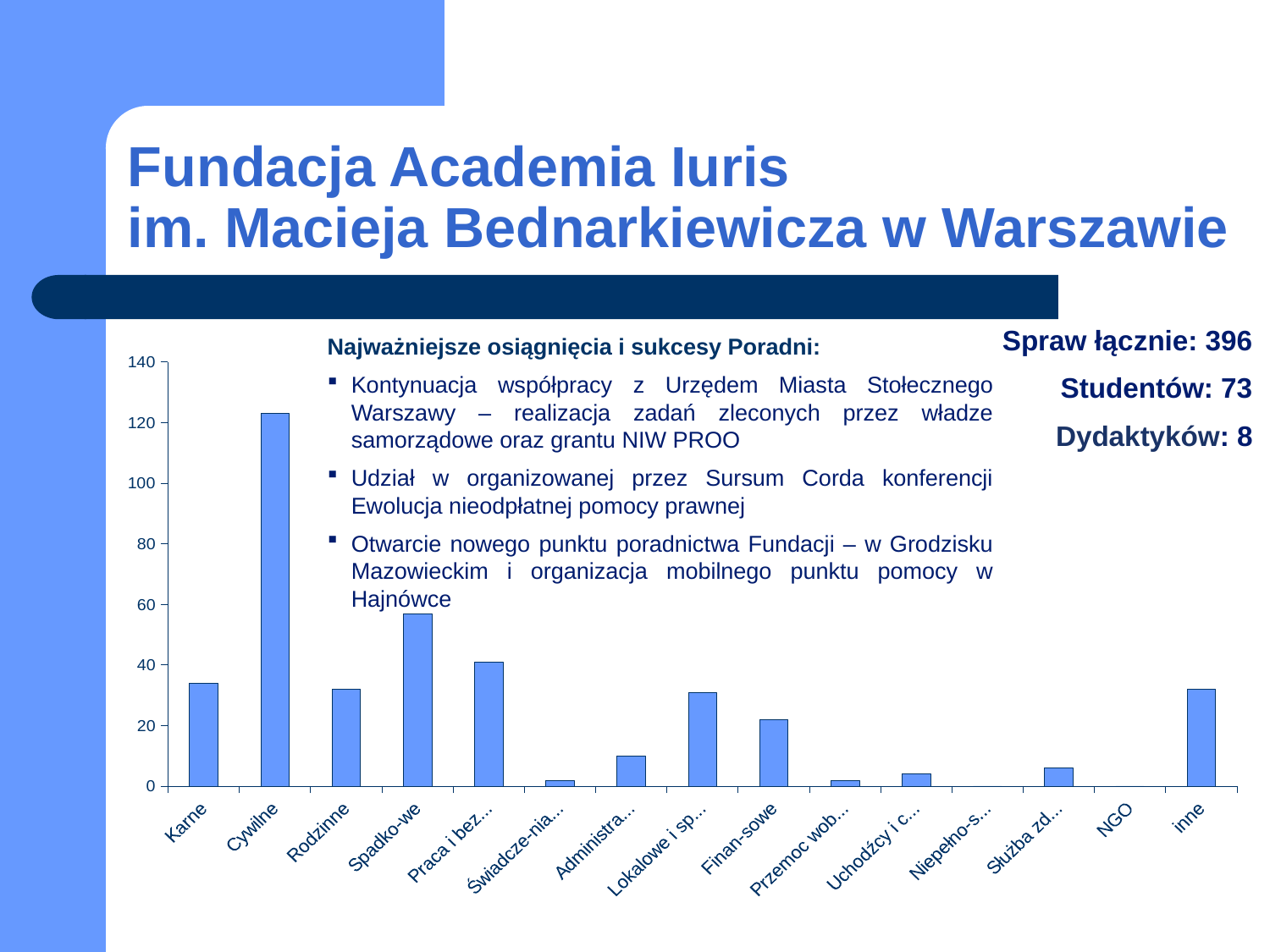
Which is larger, the value for Finan-sowe or the value for Administra...? Finan-sowe Is the value for Administra... greater or less than 20? less Is the value for Spadko-we greater or less than 40? greater Which is larger, the value for Cywilne or the value for Spadko-we? Cywilne How many categories are shown on the x axis of the chart? 15 Which category has the highest bar in the chart? Cywilne Is the value for Cywilne greater or less than 100? greater What is the highest value shown on the y axis of the chart? 140 What kind of chart is shown on the slide? bar chart